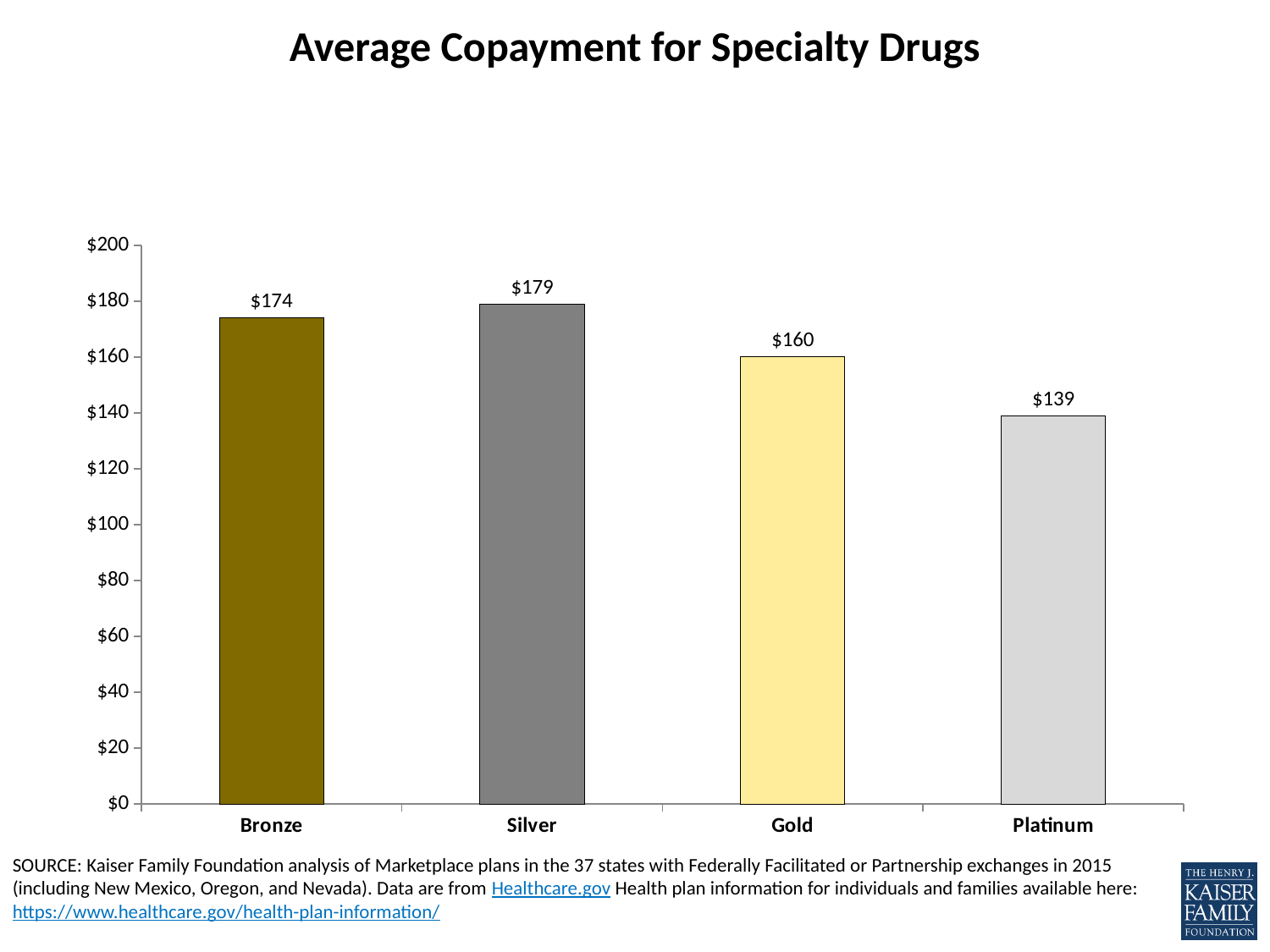
Which has a larger average copayment for specialty drugs, Gold or Platinum? Gold Which plan type has the lowest average copayment for specialty drugs? Platinum Is the average copayment for Platinum plans greater or less than $140? less Which plan type has the highest average copayment for specialty drugs? Silver What kind of chart is shown on the slide? Bar chart What is the average copayment for specialty drugs for Silver plans? $179 What is the difference between the average copayment for Silver and Platinum plans? $40 How many plan types are shown in the chart? 4 What is the average copayment for specialty drugs for Gold plans? $160 What is the difference between the average copayment for Bronze and Gold plans? $14 What is the average copayment for specialty drugs for Platinum plans? $139 What is the average copayment for specialty drugs for Bronze plans? $174